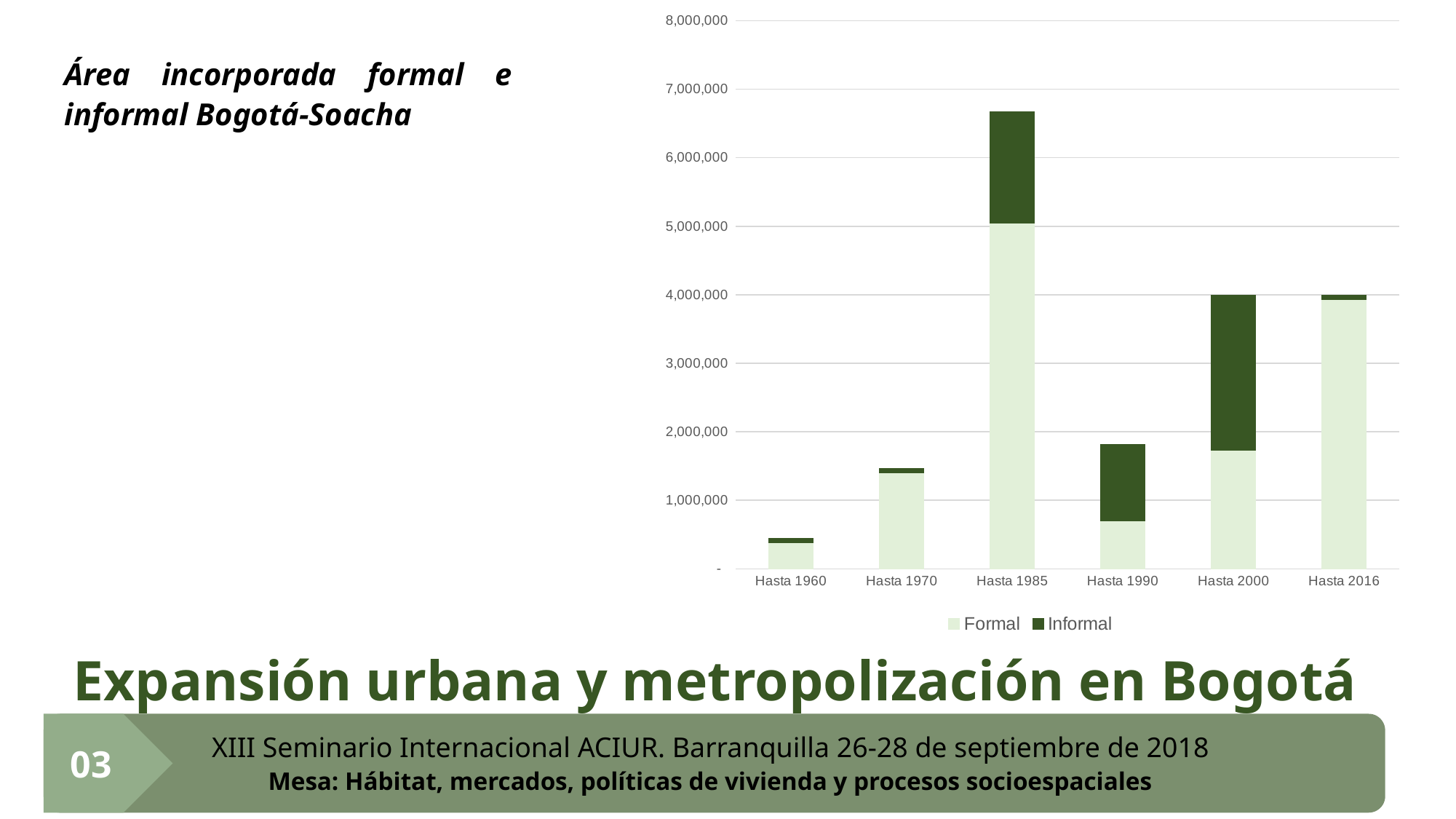
Which category has the tallest stacked bar in the chart? Hasta 1985 What kind of chart is shown on the slide? Stacked bar chart How many series does the chart's legend list? 2 Is the total value for Hasta 1985 greater or less than 6,000,000? greater Is the total value for Hasta 1960 greater or less than 1,000,000? less What are the two series named in the chart's legend? Formal and Informal Which category has the largest Informal segment? Hasta 2000 Which has the larger total bar, Hasta 1990 or Hasta 2000? Hasta 2000 Which category has the shortest stacked bar in the chart? Hasta 1960 Is the total value for Hasta 1990 greater or less than 2,000,000? less How many categories are shown on the x axis of the chart? 6